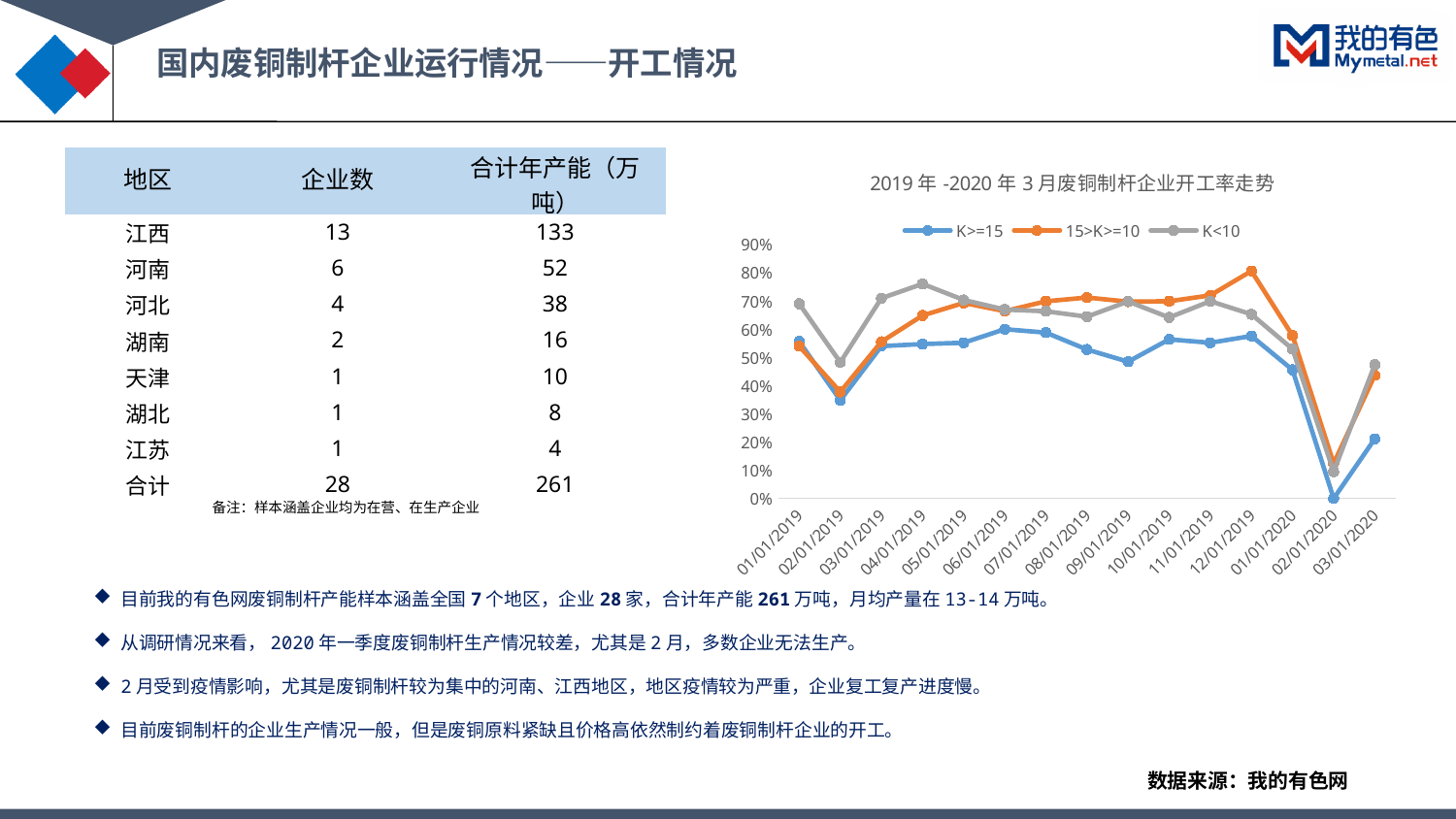
In the line chart, is the value for 15>K>=10 at 12/01/2019 greater or less than 70%? greater In the line chart, is the value for K<10 at 04/01/2019 greater or less than 70%? greater What is the title of the line chart? 2019年-2020年3月废铜制杆企业开工率走势 In the line chart, is the value for K>=15 at 02/01/2019 greater or less than 40%? less In the line chart, at 02/01/2020, which series has the higher value: K>=15 or 15>K>=10? 15>K>=10 What kind of chart is shown on the right side of the slide? line chart Which series in the line chart is drawn in orange? 15>K>=10 How many series does the legend of the line chart list? 3 How many dates are plotted along the x axis of the line chart? 15 In the line chart, does the K>=15 series rise or fall from 12/01/2019 to 02/01/2020? fall In the line chart, on which date does the K>=15 series reach its lowest value? 02/01/2020